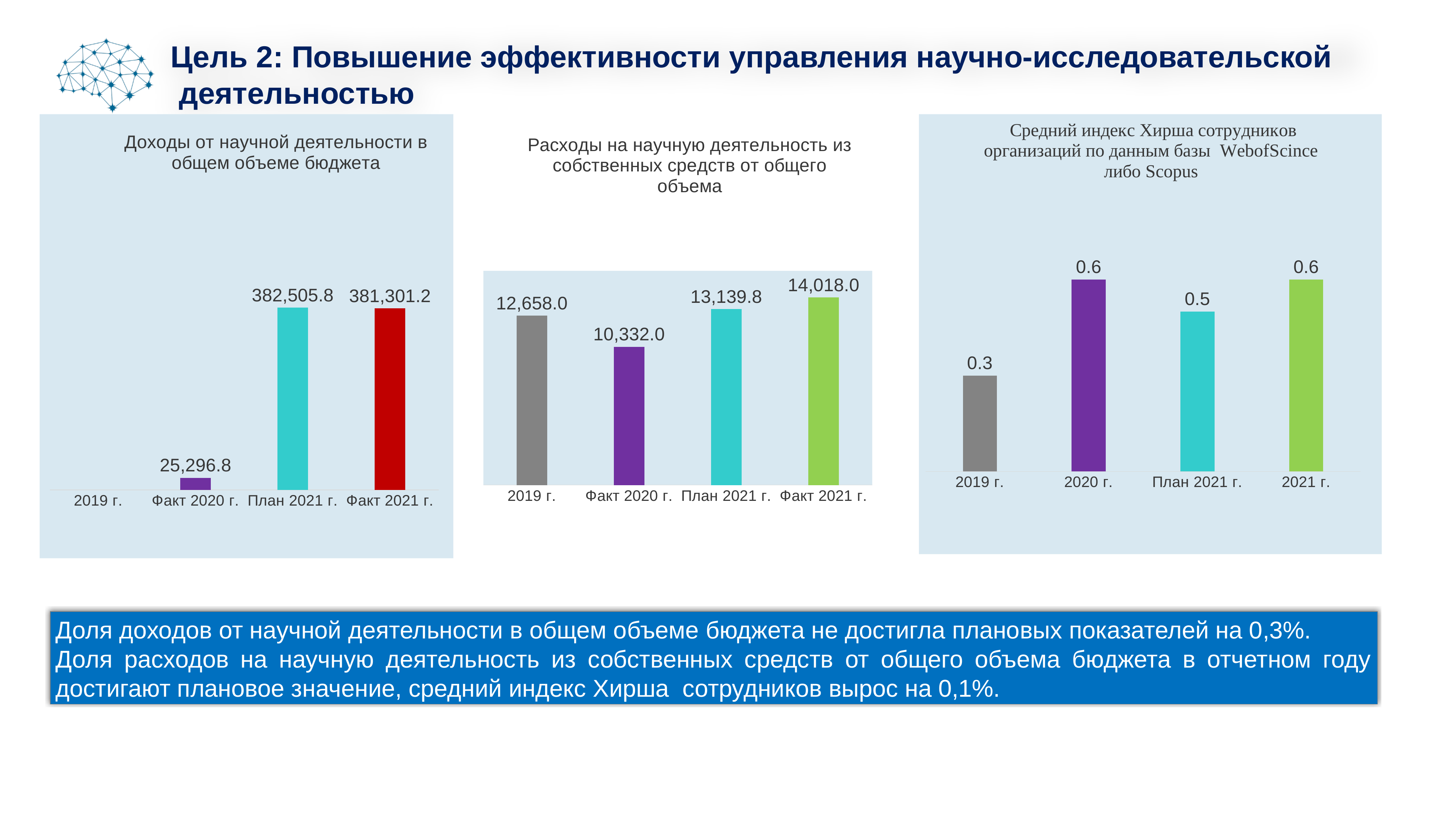
In the chart 'Доходы от научной деятельности в общем объеме бюджета', what is the value for План 2021 г.? 382,505.8 In the chart 'Доходы от научной деятельности в общем объеме бюджета', which category has the highest value? План 2021 г. In the chart 'Средний индекс Хирша сотрудников организаций', which category has the lowest value? 2019 г. In the chart 'Средний индекс Хирша сотрудников организаций', what is the value for 2019 г.? 0.3 In the chart 'Расходы на научную деятельность из собственных средств от общего объема', what is the value for 2019 г.? 12,658.0 In the chart 'Доходы от научной деятельности в общем объеме бюджета', what is the value for Факт 2020 г.? 25,296.8 In the chart 'Доходы от научной деятельности в общем объеме бюджета', what is the difference between План 2021 г. and Факт 2021 г.? 1,204.6 What type of chart is the middle chart 'Расходы на научную деятельность из собственных средств от общего объема'? Bar chart In the chart 'Расходы на научную деятельность из собственных средств от общего объема', which category has the highest value? Факт 2021 г. In the chart 'Расходы на научную деятельность из собственных средств от общего объема', what is the difference between Факт 2021 г. and План 2021 г.? 878.2 In the chart 'Расходы на научную деятельность из собственных средств от общего объема', which category has the lowest value? Факт 2020 г. In the chart 'Средний индекс Хирша сотрудников организаций', which is larger: 2021 г. or План 2021 г.? 2021 г.